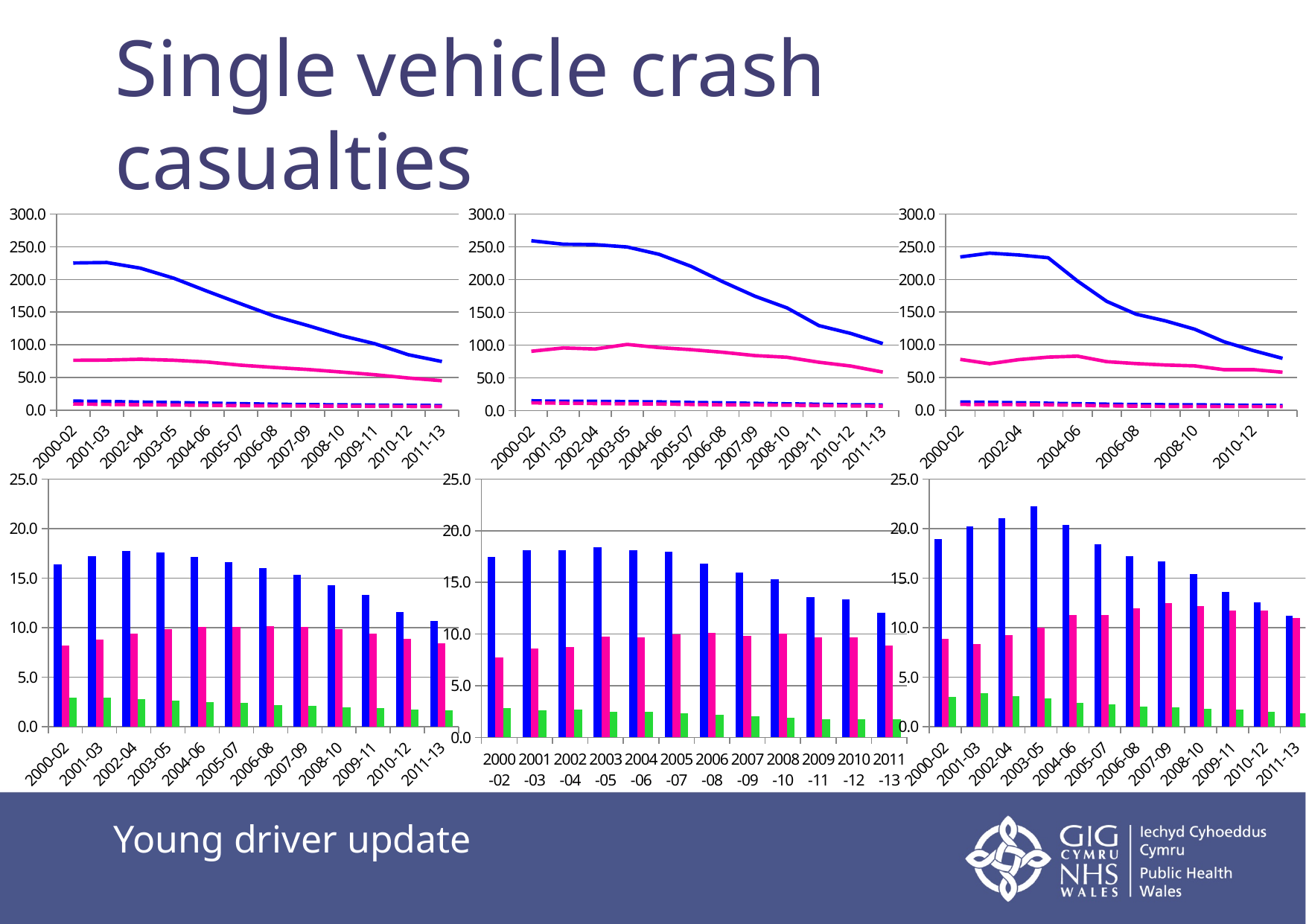
In the top-middle line chart, is the value of the solid blue line for 2000-02 greater or less than 250? greater In the bottom-right bar chart, is the blue bar for 2011-13 greater or less than 15? less In the top-right line chart, is the value of the solid blue line for the last period greater or less than 100? less In the bottom-right bar chart, which period has the tallest blue bar? 2003-05 What kind of chart is the top-left chart on the slide? line chart In the top-left line chart, how many time periods are shown along the x axis? 12 In the bottom-left bar chart, how many differently coloured bar series are plotted for each period? 3 In the bottom-left bar chart, which period has the shortest blue bar? 2011-13 In the bottom-left bar chart, which is larger for 2000-02: the blue bar or the pink bar? the blue bar What kind of chart is the bottom-left chart on the slide? bar chart In the top-left line chart, does the solid blue line rise or fall from 2000-02 to 2011-13? falls